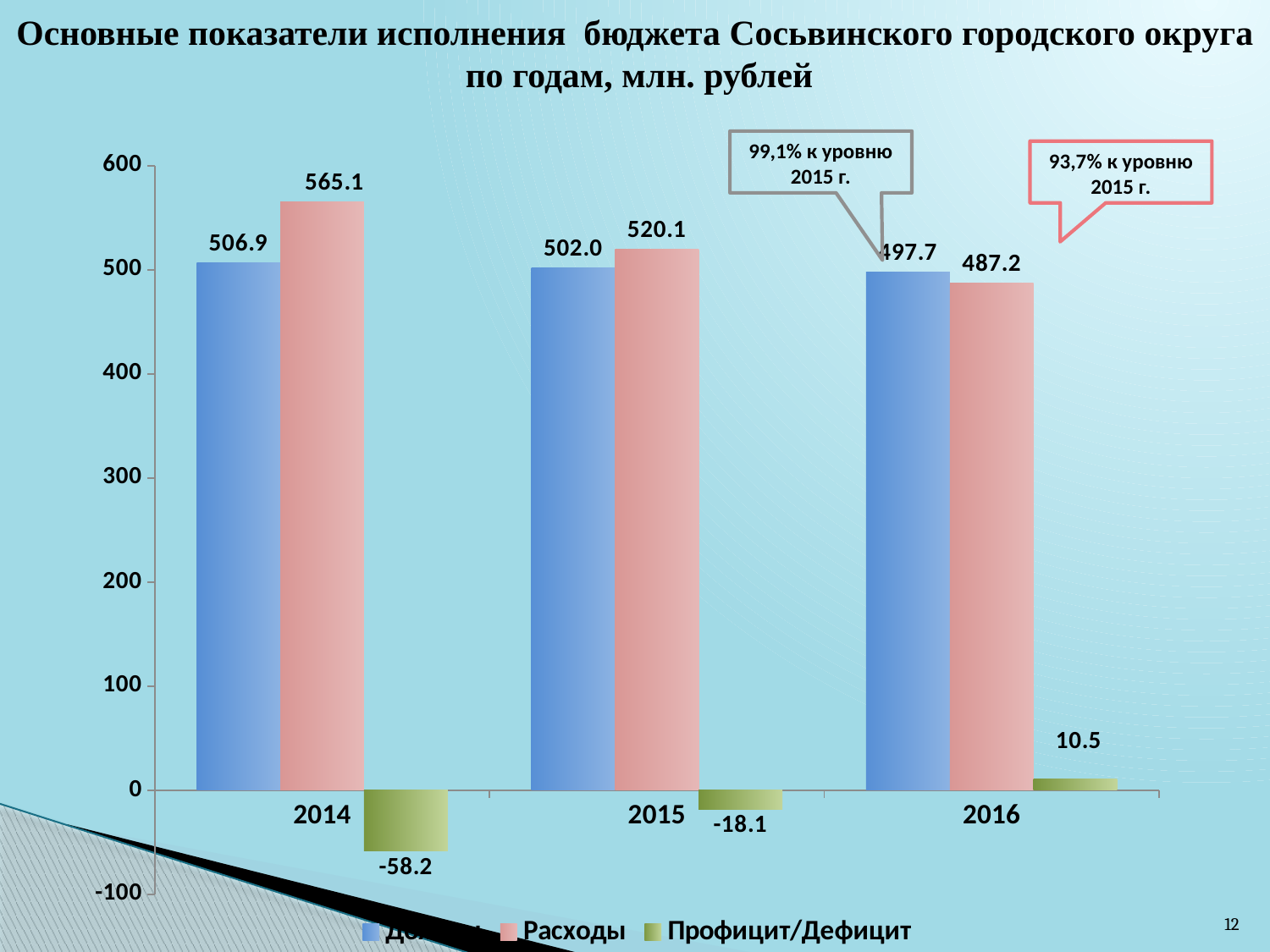
What is the value of the blue series for 2015? 502.0 What kind of chart is shown on the slide? bar chart Do the Расходы values rise or fall from 2014 to 2016? fall What is the value of Профицит/Дефицит for 2016? 10.5 In which year is Профицит/Дефицит the lowest? 2014 Which is larger in 2016, the blue series or Расходы? the blue series What is the value of Расходы for 2014? 565.1 What is the difference between Расходы and the blue series in 2015? 18.1 In which year is Расходы the highest? 2014 What is the value of Расходы for 2016? 487.2 How many series does the legend list? 3 How many years are shown on the x axis? 3